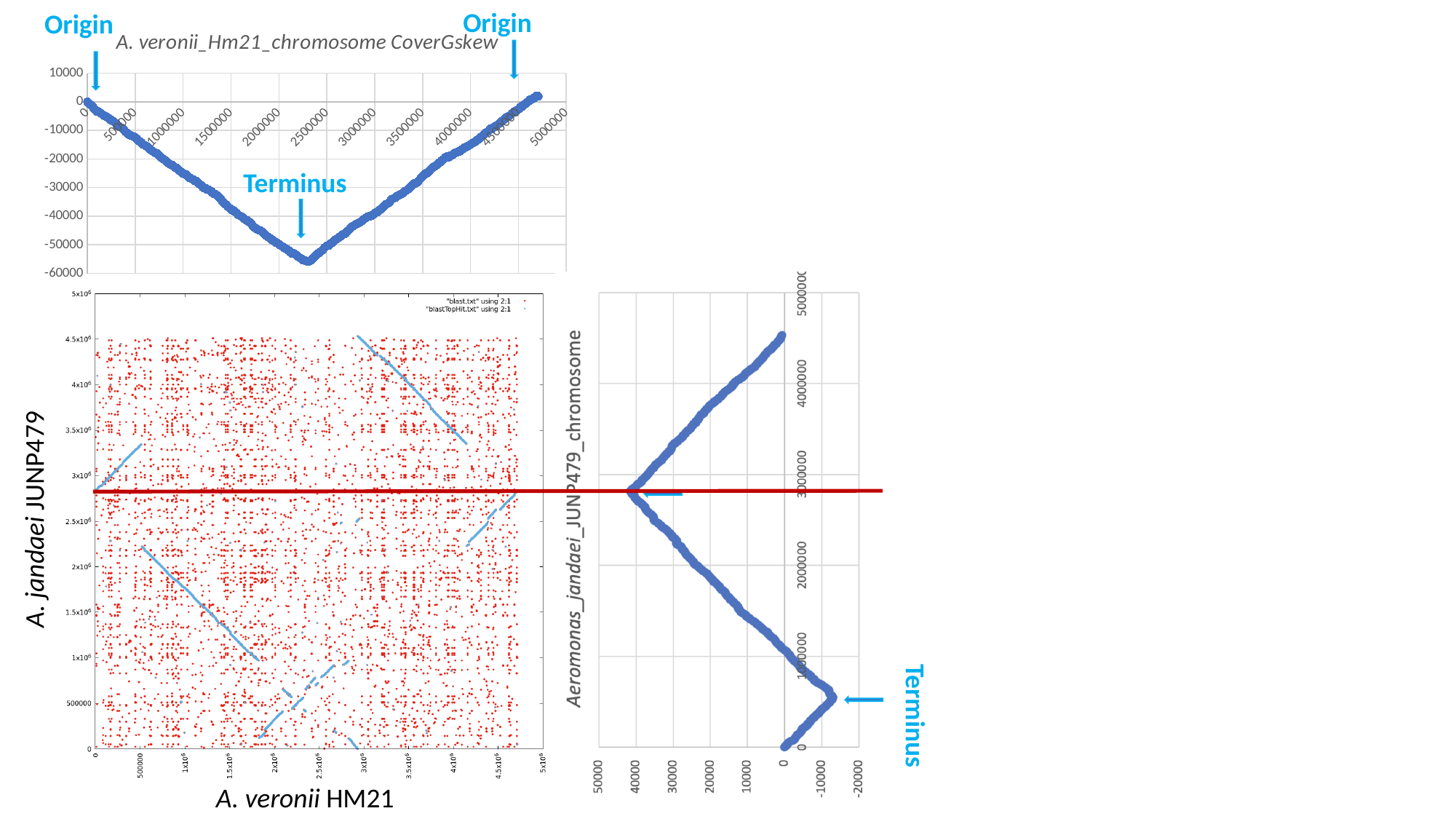
In the top chart (A. veronii_Hm21_chromosome CoverGskew), which labelled point marks the minimum of the curve? Terminus In the bottom-right chart (Aeromonas_jandaei_JUNP479_chromosome), is the value at the point labelled Terminus greater or less than 0? less In the top chart (A. veronii_Hm21_chromosome CoverGskew), is the value at position 2500000 greater or less than -50000? less In the top chart (A. veronii_Hm21_chromosome CoverGskew), do the values rise or fall between position 2500000 and position 5000000? rise What kind of chart is the bottom-left chart comparing A. veronii HM21 and A. jandaei JUNP479? scatter plot In the bottom-right chart (Aeromonas_jandaei_JUNP479_chromosome), is the value at position 3000000 larger or smaller than the value at position 1000000? larger How many series does the legend of the bottom-left dot plot list? 2 What is the label of the horizontal axis of the bottom-left dot plot? A. veronii HM21 In the bottom-right chart (Aeromonas_jandaei_JUNP479_chromosome), is the value at position 3000000 greater or less than 30000? greater What is the title of the top chart? A. veronii_Hm21_chromosome CoverGskew In the top chart (A. veronii_Hm21_chromosome CoverGskew), do the values rise or fall between position 0 and position 2500000? fall In the top chart (A. veronii_Hm21_chromosome CoverGskew), what is the lowest value shown on the vertical axis? -60000